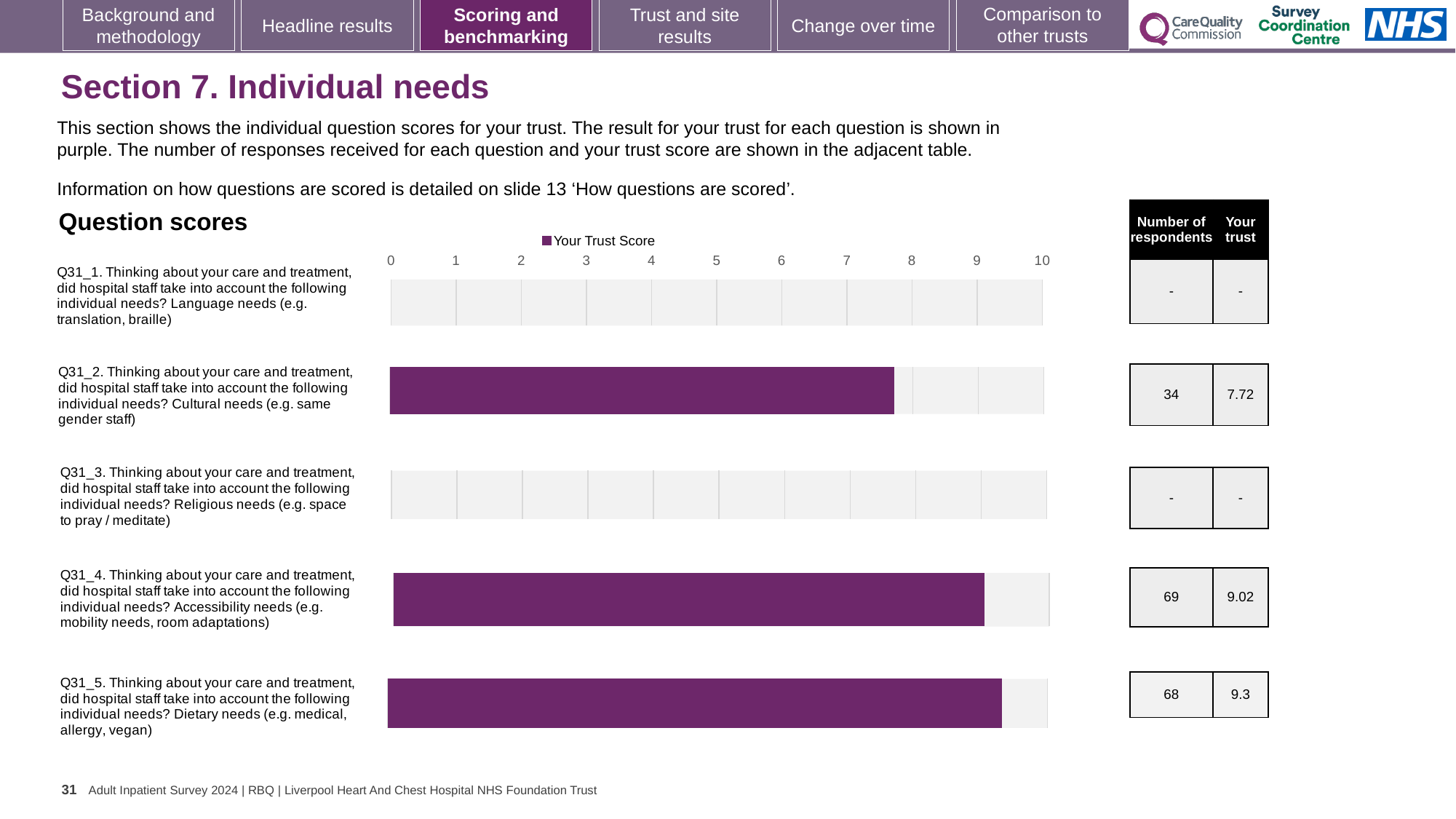
Among the questions with a plotted score, which has the lowest trust score? Q31_2 (Cultural needs) What is the trust score for Q31_4 (Accessibility needs)? 9.02 How many respondents answered Q31_4 (Accessibility needs)? 69 What kind of chart is shown on the slide? Bar chart Which question has the highest trust score? Q31_5 (Dietary needs) How many questions are listed in the chart? 5 How many series does the legend list? 1 What is the difference between the trust scores for Q31_5 and Q31_2? 1.58 What is the trust score for Q31_5 (Dietary needs)? 9.3 Is the value for Q31_2 (Cultural needs) greater or less than 8? less Which has a higher trust score, Q31_2 (Cultural needs) or Q31_4 (Accessibility needs)? Q31_4 (Accessibility needs) What is the trust score for Q31_2 (Cultural needs)? 7.72